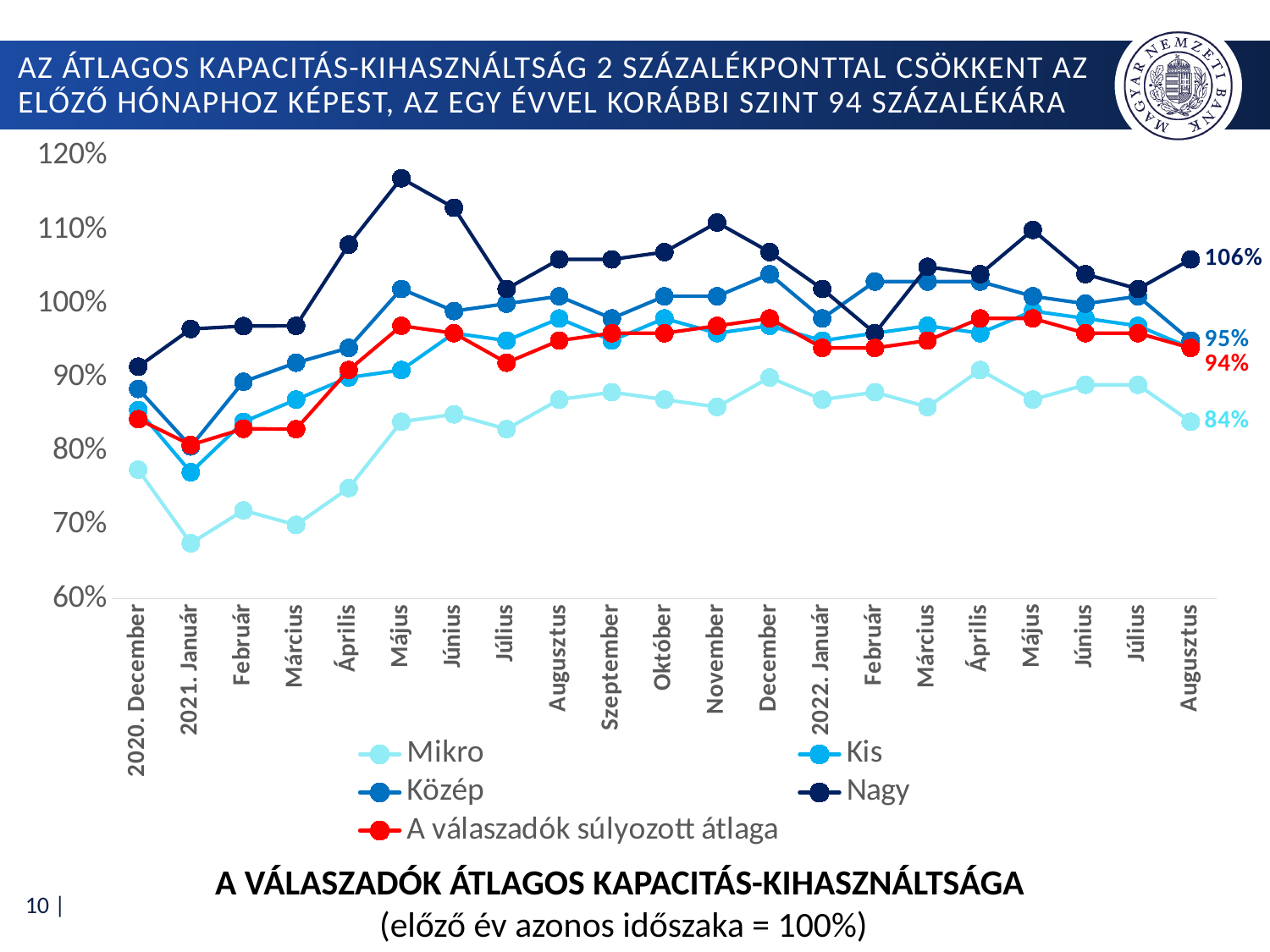
What is the title of the chart? A válaszadók átlagos kapacitás-kihasználtsága (előző év azonos időszaka = 100%) What kind of chart is shown on the slide? Line chart What is the value for Mikro in Augusztus 2022? 84% Which series has the lowest value in Augusztus 2022? Mikro What is the value of 'A válaszadók súlyozott átlaga' in Augusztus 2022? 94% How many series does the legend list? 5 How many months (points) are plotted along the x axis? 21 Is the value for Nagy in Május 2021 greater or less than 110%? greater Is the value for Mikro in 2021. Január greater or less than 70%? less What is the difference between the Nagy and Mikro values in Augusztus 2022? 22 percentage points What is the value for Nagy in Augusztus 2022? 106% Which series has the highest value in Augusztus 2022? Nagy